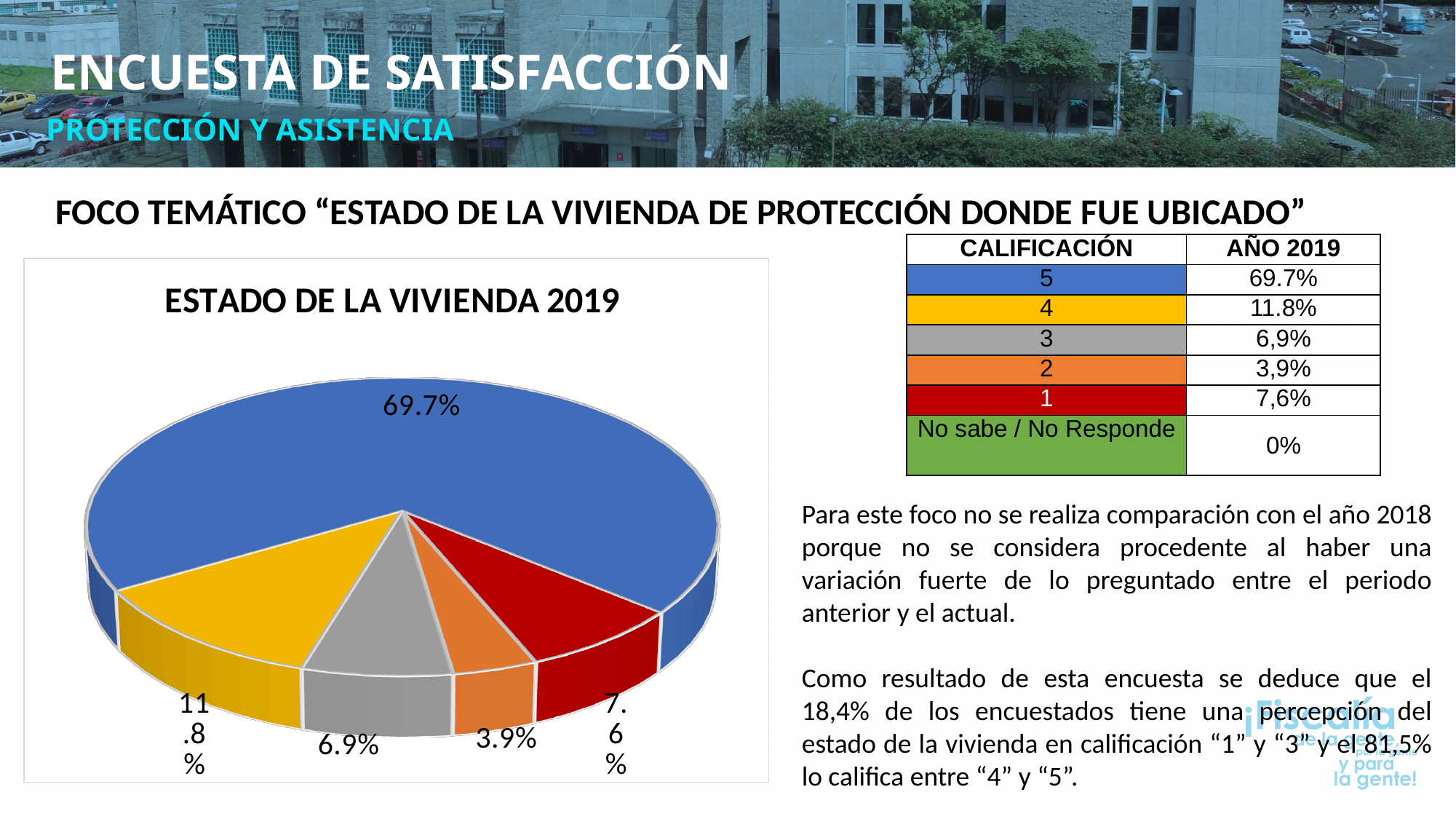
In the pie chart "ESTADO DE LA VIVIENDA 2019", what percentage is labelled on the gray slice? 6.9% In the pie chart "ESTADO DE LA VIVIENDA 2019", what percentage is labelled on the yellow slice? 11.8% In the pie chart "ESTADO DE LA VIVIENDA 2019", which slice has the largest labelled percentage? The blue slice (69.7%) What kind of chart is shown under the title "ESTADO DE LA VIVIENDA 2019"? Pie chart In the pie chart "ESTADO DE LA VIVIENDA 2019", what is the difference between the blue slice (69.7%) and the yellow slice (11.8%)? 57.9% In the pie chart "ESTADO DE LA VIVIENDA 2019", what percentage is labelled on the red slice? 7.6% In the pie chart "ESTADO DE LA VIVIENDA 2019", how many slices are labelled with a percentage? 5 In the pie chart "ESTADO DE LA VIVIENDA 2019", what is the difference between the yellow slice (11.8%) and the orange slice (3.9%)? 7.9% What is the title of the pie chart on the slide? ESTADO DE LA VIVIENDA 2019 In the pie chart "ESTADO DE LA VIVIENDA 2019", which is larger, the red slice or the gray slice? The red slice (7.6%) In the pie chart "ESTADO DE LA VIVIENDA 2019", which slice has the smallest labelled percentage? The orange slice (3.9%) In the pie chart "ESTADO DE LA VIVIENDA 2019", what percentage is shown for the largest (blue) slice? 69.7%